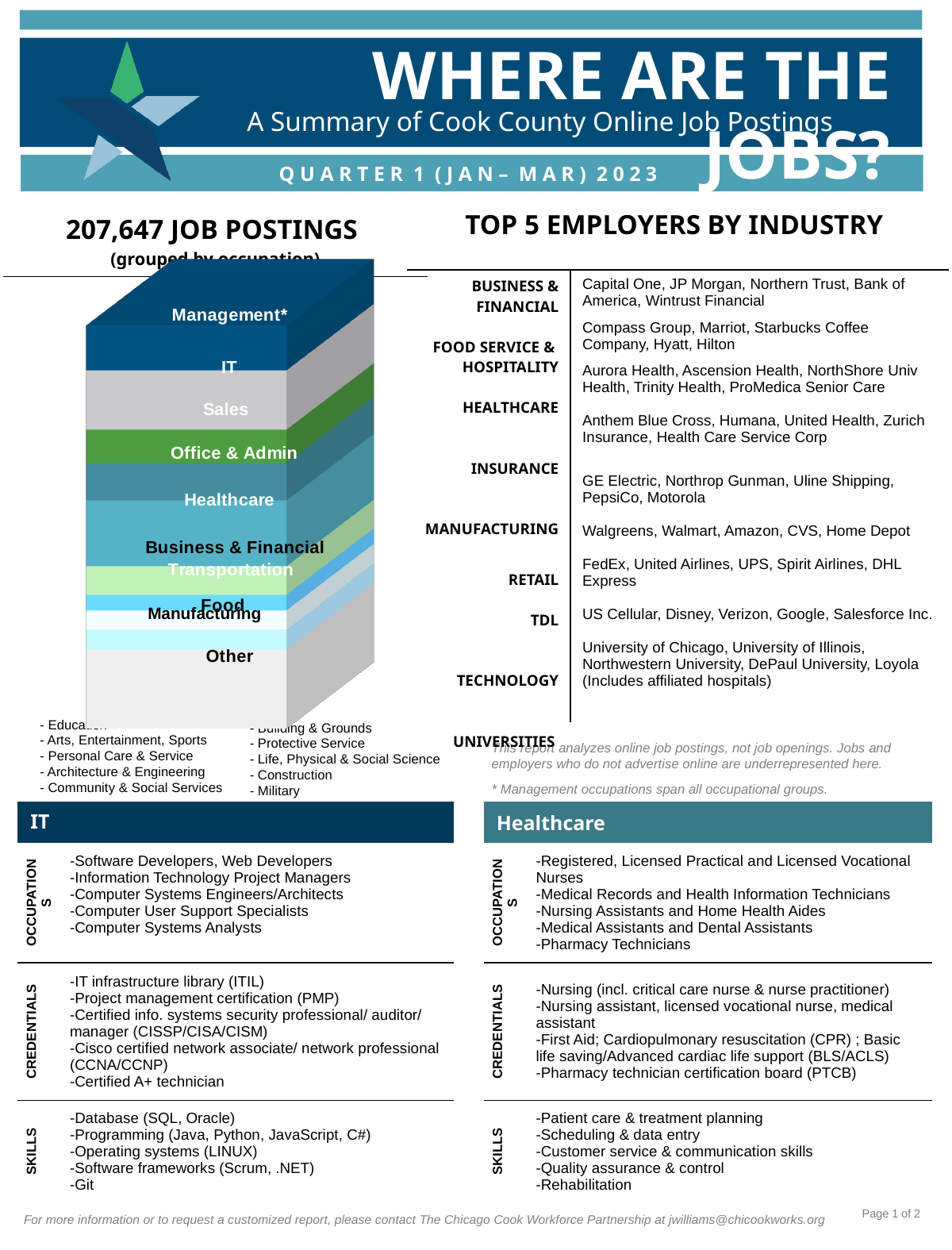
Which segment is at the bottom of the stacked bar? Other Which segment is larger in the stacked bar, Office & Admin or Food? Office & Admin What total number of job postings is given in the chart's title? 207,647 Which segment is at the top of the stacked bar? Management* How many occupation segments are labeled in the stacked bar chart? 10 Which segment is larger in the stacked bar, Management* or Manufacturing? Management* Which segment is larger in the stacked bar, Healthcare or Transportation? Healthcare What kind of chart is used to show the job postings grouped by occupation? Stacked bar chart According to the chart title, how are the 207,647 job postings grouped? By occupation Which segment appears directly below IT in the stacked bar? Sales